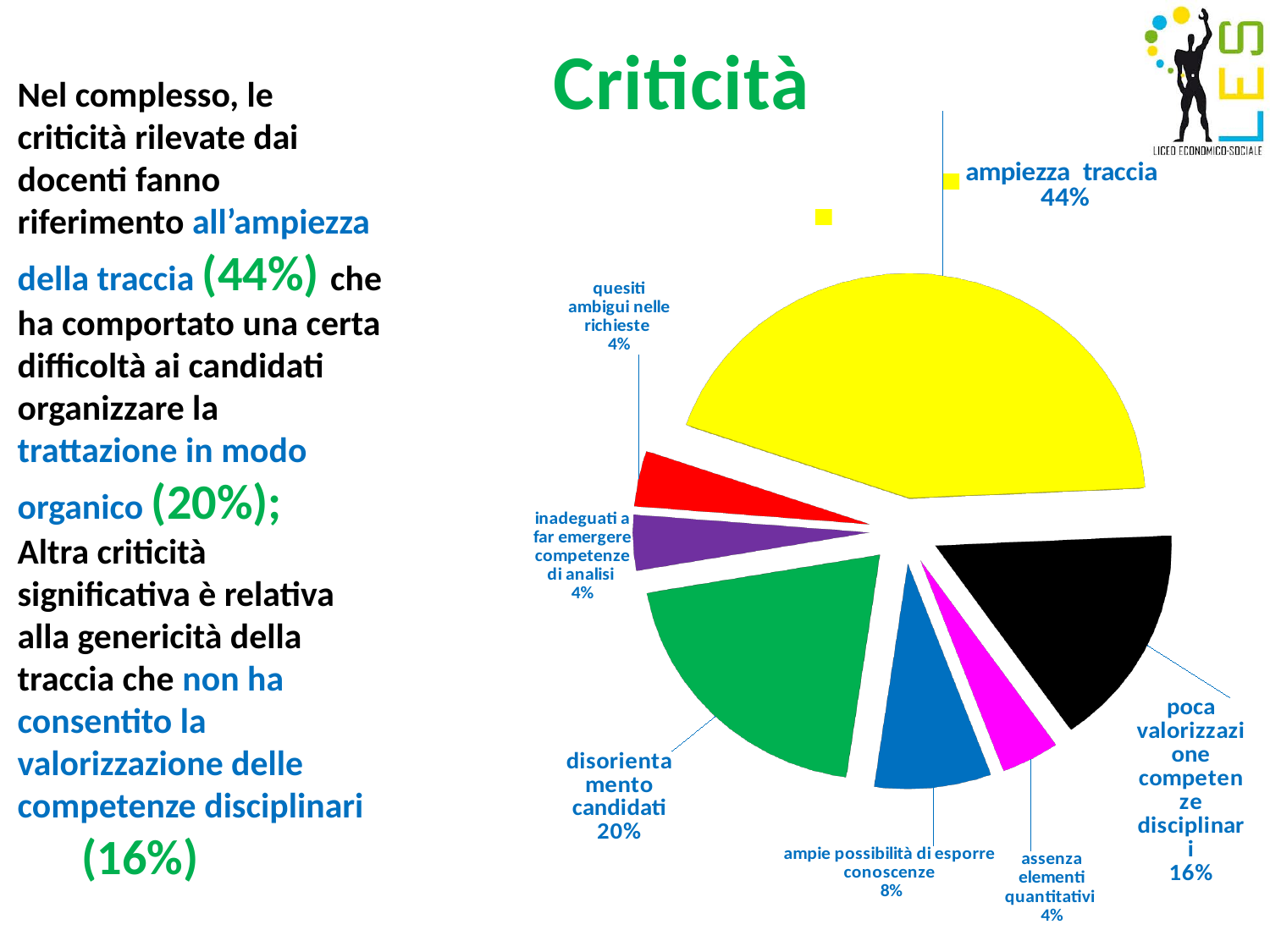
Which is larger, "poca valorizzazione competenze disciplinari" or "ampie possibilità di esporre conoscenze"? poca valorizzazione competenze disciplinari What kind of chart is shown on the slide? pie chart What percentage is shown for "disorientamento candidati"? 20% What percentage is shown for "assenza elementi quantitativi"? 4% What percentage is shown for "ampiezza traccia"? 44% Which category has the largest slice of the pie? ampiezza traccia What percentage is shown for "ampie possibilità di esporre conoscenze"? 8% What is the difference in percentage points between "ampiezza traccia" and "disorientamento candidati"? 24 What is the title of the chart? Criticità How many slices does the pie chart have? 7 What percentage is shown for "poca valorizzazione competenze disciplinari"? 16% What colour is the slice for "ampiezza traccia"? yellow